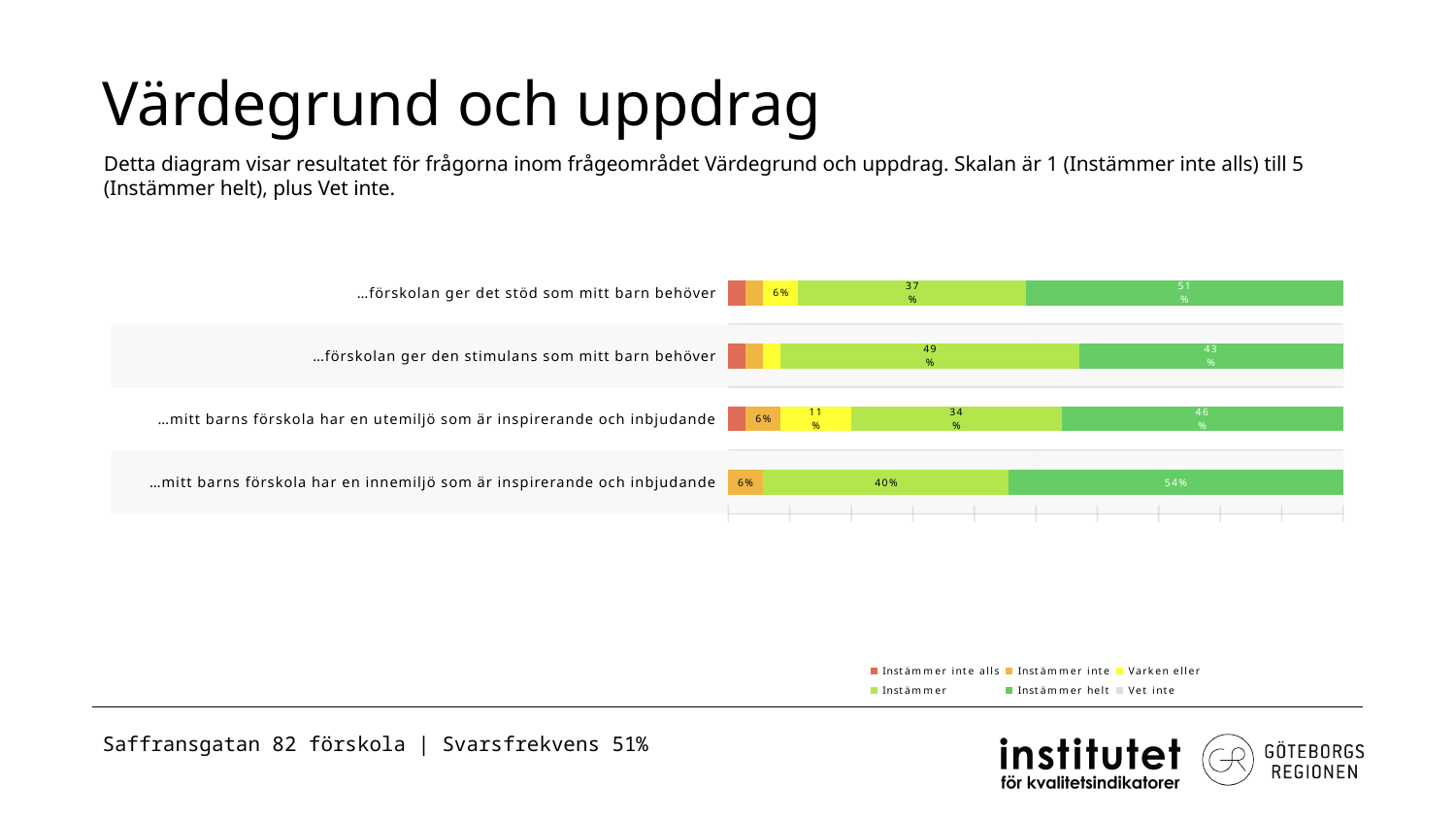
What type of chart is shown on the slide? Stacked bar chart Which question has the lowest share of 'Instämmer helt'? …förskolan ger den stimulans som mitt barn behöver How many questions (bars) are shown in the chart? 4 What percentage answered 'Instämmer' for '…förskolan ger den stimulans som mitt barn behöver'? 49% Which question has a larger 'Instämmer' share: '…förskolan ger den stimulans som mitt barn behöver' or '…förskolan ger det stöd som mitt barn behöver'? …förskolan ger den stimulans som mitt barn behöver Which question has the highest share of 'Instämmer helt'? …mitt barns förskola har en innemiljö som är inspirerande och inbjudande For '…förskolan ger det stöd som mitt barn behöver', how much larger is the 'Instämmer helt' share than the 'Instämmer' share? 14 percentage points What percentage answered 'Instämmer helt' for '…mitt barns förskola har en innemiljö som är inspirerande och inbjudande'? 54% Which colour represents 'Instämmer helt' in the legend? Green How many response categories does the legend list? 6 What percentage answered 'Instämmer' for '…mitt barns förskola har en utemiljö som är inspirerande och inbjudande'? 34% What percentage answered 'Varken eller' for '…mitt barns förskola har en utemiljö som är inspirerande och inbjudande'? 11%